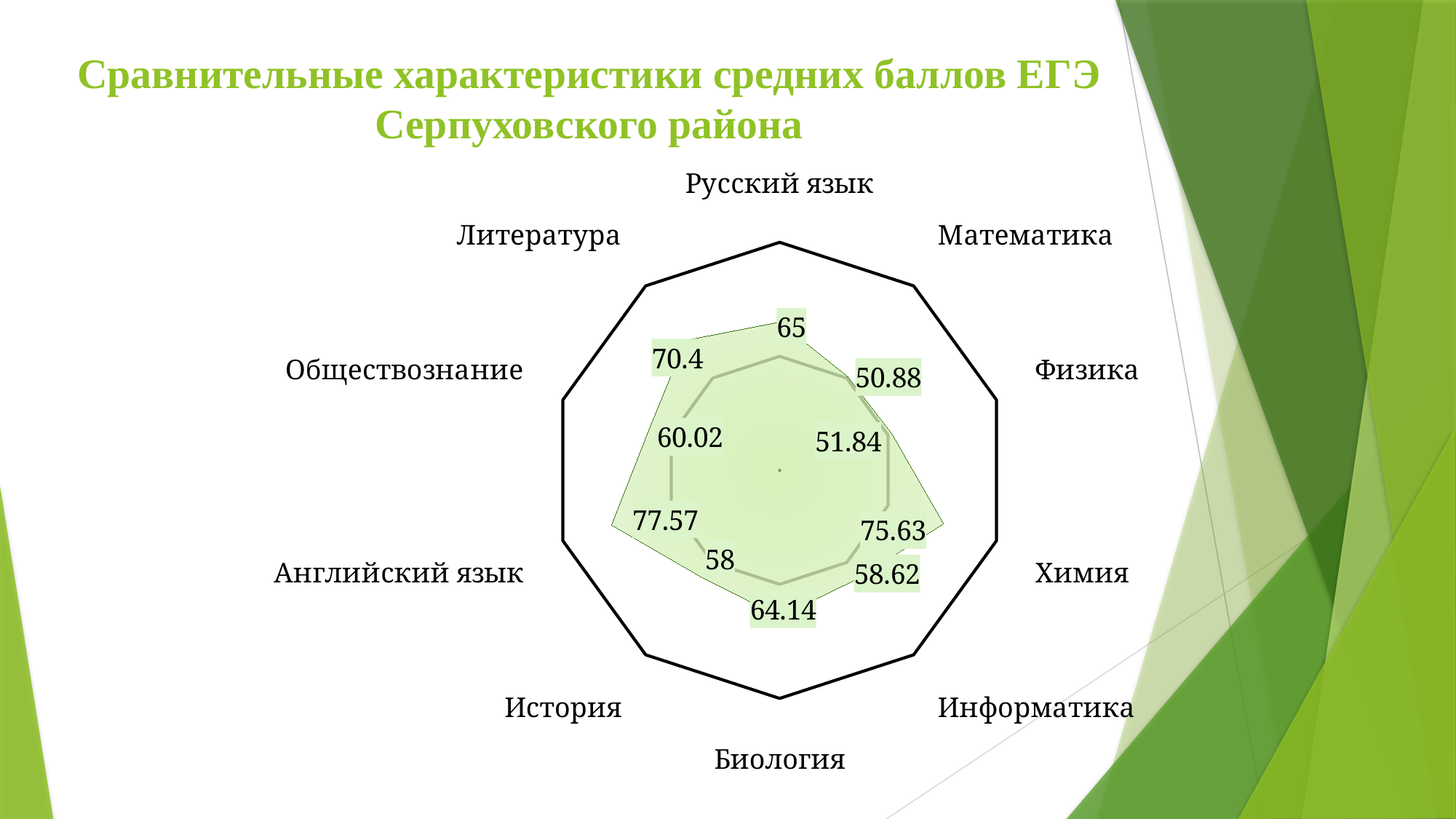
Which has a higher average score, Химия or Биология? Химия What is the difference between the average scores for Английский язык and Математика? 26.69 How many subjects (categories) are plotted on the chart? 10 Which subject has the lowest average score? Математика What is the average score for Математика? 50.88 What is the title of the slide containing the chart? Сравнительные характеристики средних баллов ЕГЭ Серпуховского района What is the average score for Литература? 70.4 What is the average score for Английский язык? 77.57 What is the average score for Химия? 75.63 Which subject has the highest average score? Английский язык What is the average score for Русский язык? 65 What type of chart is shown on the slide? Radar chart